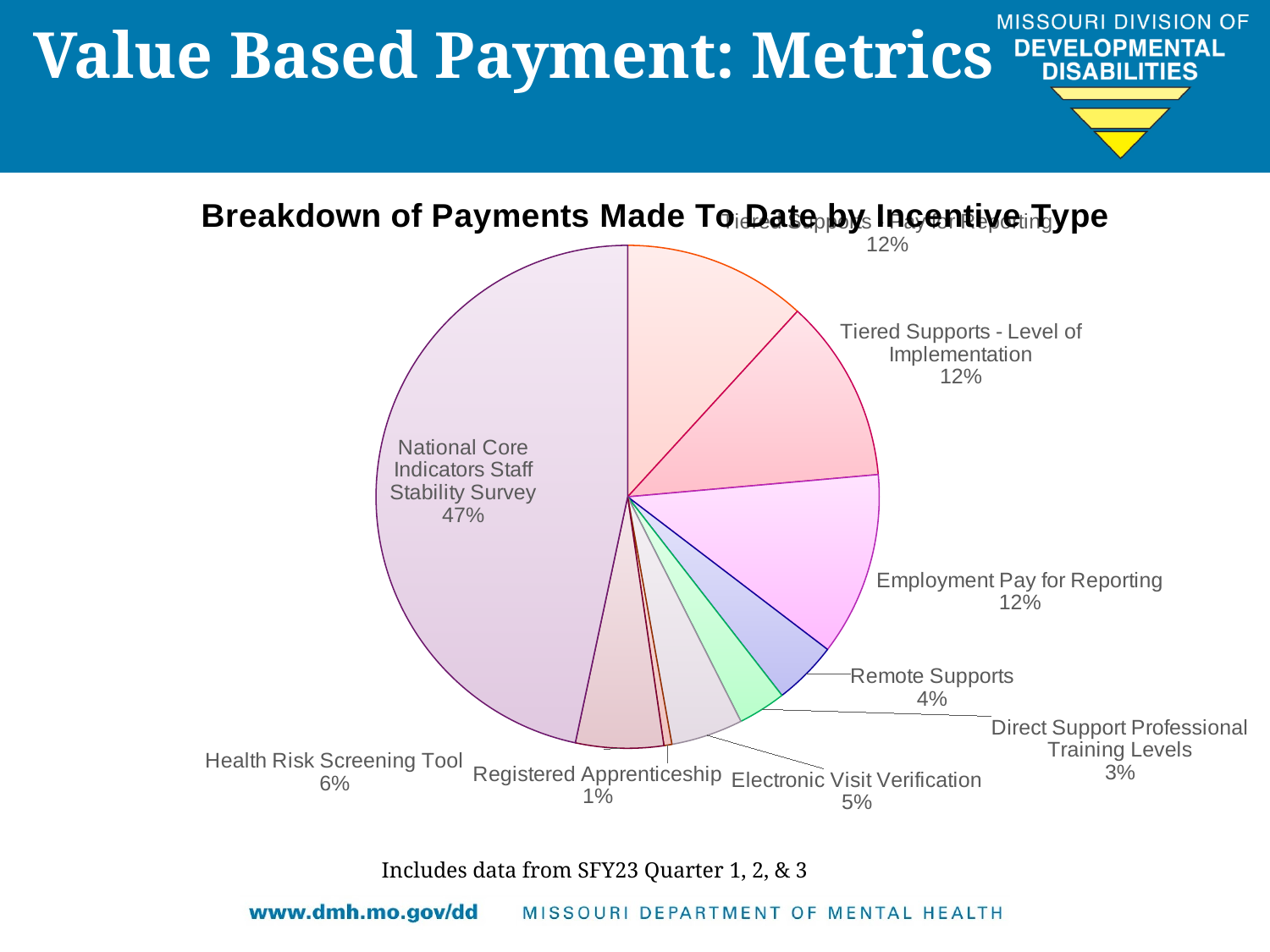
What is the difference in percentage points between Health Risk Screening Tool and Direct Support Professional Training Levels? 3 What percentage of payments is shown for Tiered Supports - Level of Implementation? 12% What percentage of payments is shown for Employment Pay for Reporting? 12% What kind of chart is shown on the slide? Pie chart Which incentive type has the largest share of payments? National Core Indicators Staff Stability Survey How many slices does the pie chart have? 9 Which has a larger share of payments, Electronic Visit Verification or Remote Supports? Electronic Visit Verification Which incentive type has the smallest share of payments? Registered Apprenticeship What percentage of payments is shown for Remote Supports? 4% What share of payments went to the National Core Indicators Staff Stability Survey? 47% What is the title of the chart? Breakdown of Payments Made To Date by Incentive Type What percentage of payments is shown for Electronic Visit Verification? 5%